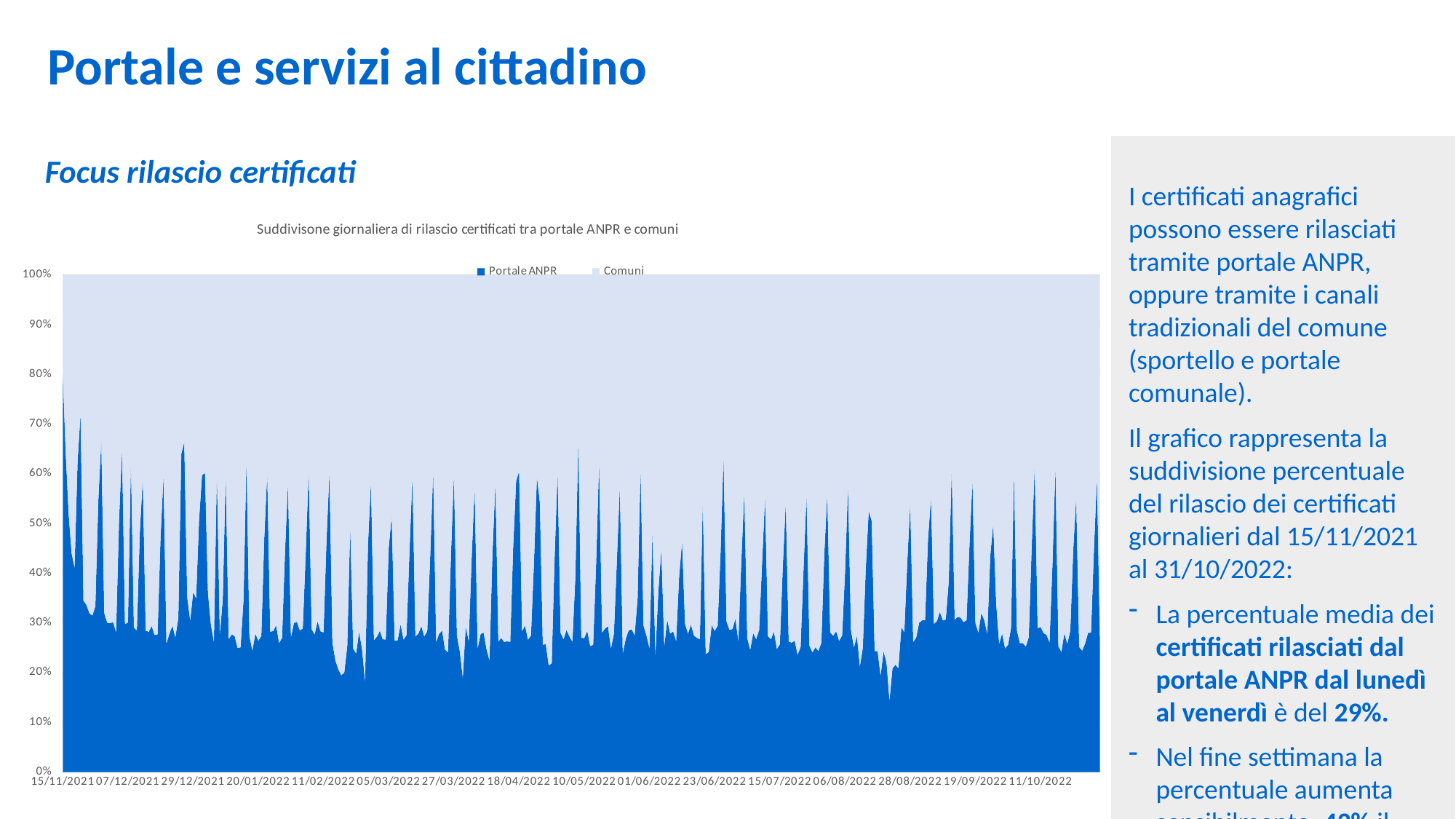
What is the maximum value shown on the y axis of the chart? 100% What kind of chart is shown on the slide? Stacked area chart Is the Comuni share on 15/11/2021 greater or less than 30%? less What is the title of the chart? Suddivisone giornaliera di rilascio certificati tra portale ANPR e comuni Is the Portale ANPR share on 15/11/2021 greater or less than 70%? greater What is the first date label on the x axis of the chart? 15/11/2021 How many date labels are printed along the x axis of the chart? 16 What are the two series named in the chart legend? Portale ANPR and Comuni How many series does the chart legend list? 2 Is the lowest Portale ANPR share, reached around late August 2022, greater or less than 20%? less Which series is drawn in dark blue at the bottom of the chart? Portale ANPR What is the last date label on the x axis of the chart? 11/10/2022